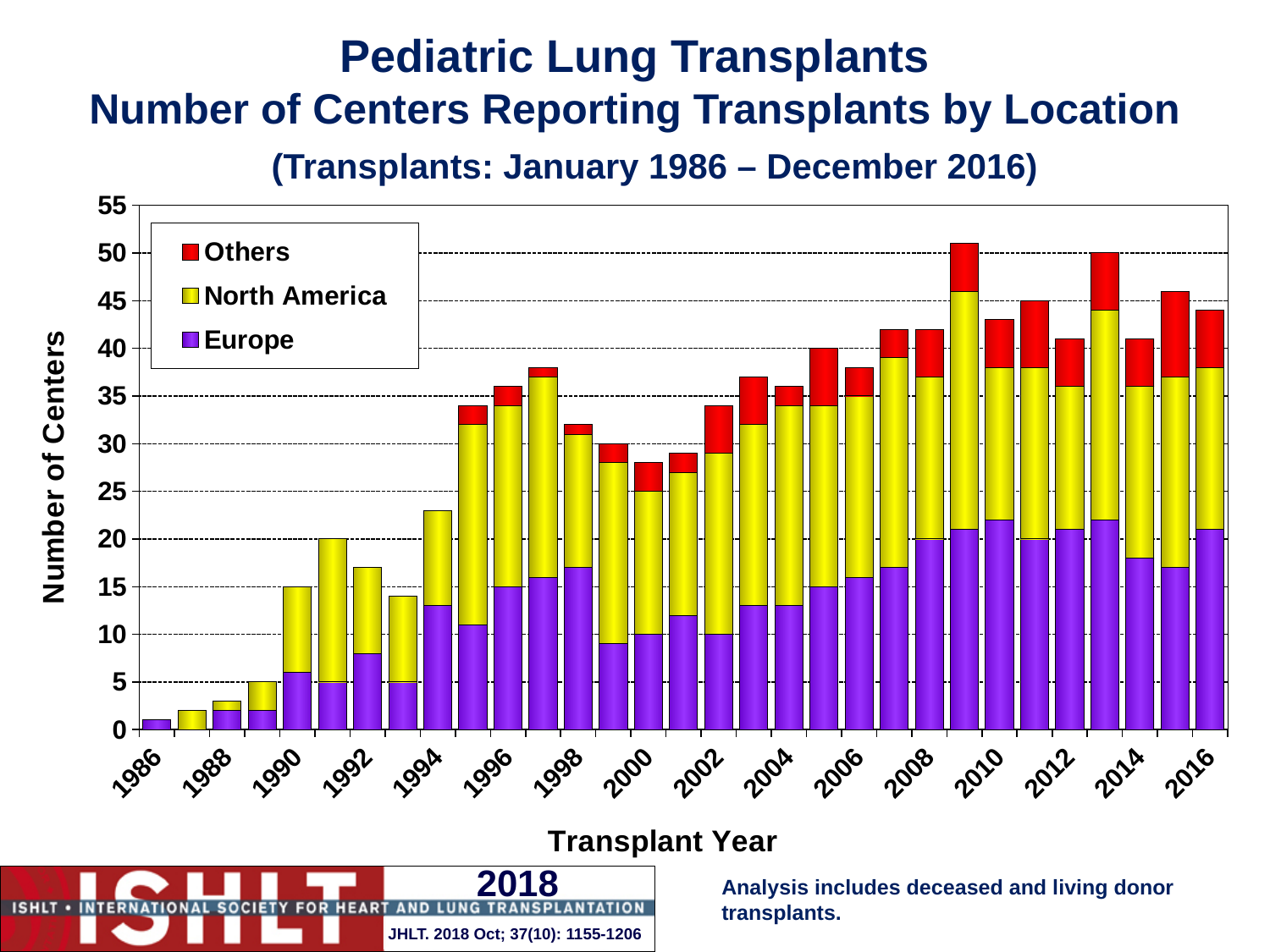
Does the total number of centers rise or fall from 1986 to 1990? rise How many series does the legend list? 3 Is the Europe value for 2010 greater or less than 15? greater Which series is shown in red in the legend? Others Which year has the lowest total number of centers? 1986 How many transplant years (bars) are plotted, from 1986 to 2016? 31 Is the total number of centers for 2009 greater or less than 45? greater Is the total number of centers for 1994 greater or less than 20? greater What kind of chart is shown on the slide? stacked bar chart What is the title of the y axis? Number of Centers Which year has the larger total number of centers, 1990 or 1995? 1995